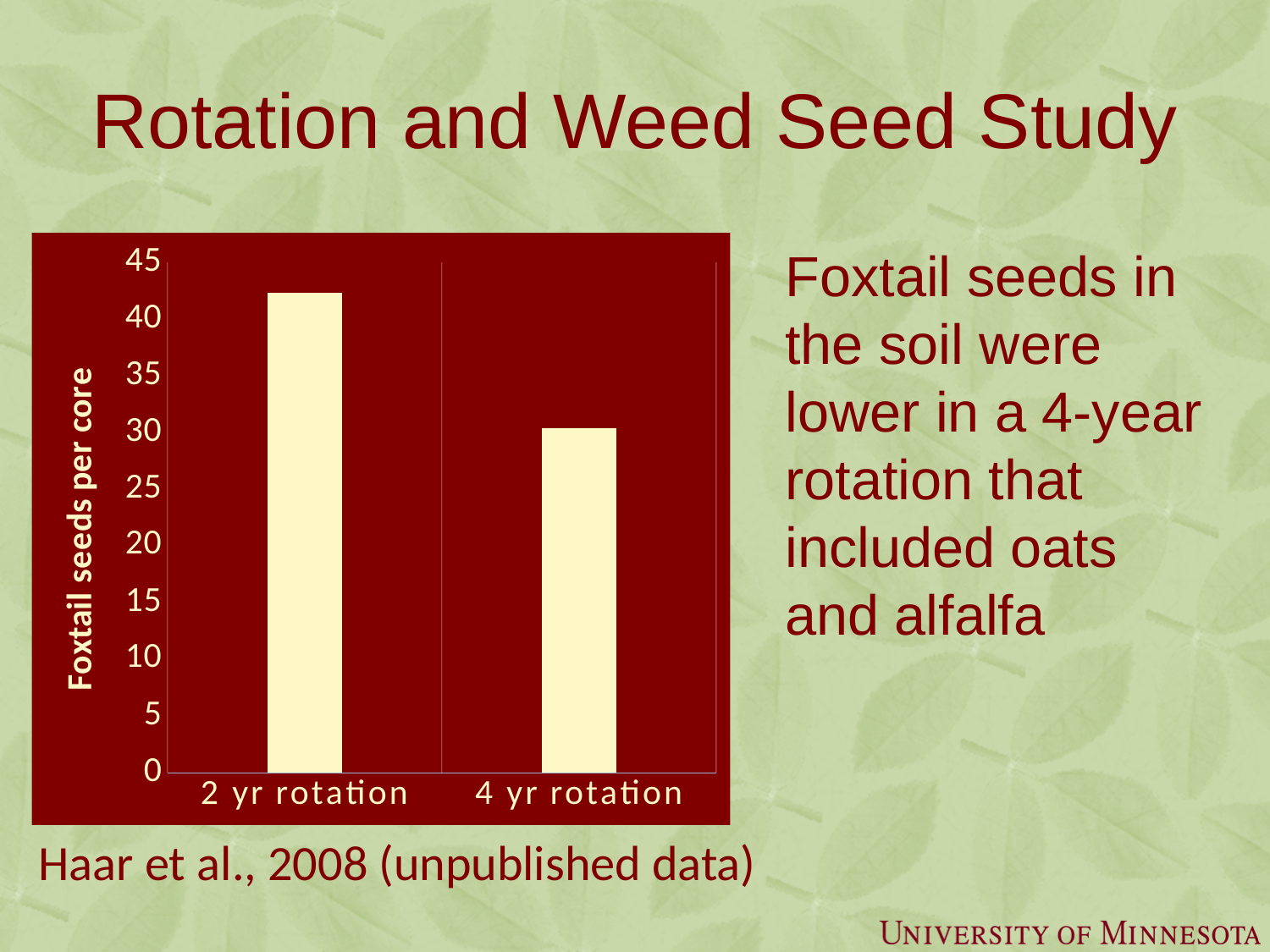
Do the values rise or fall from 2 yr rotation to 4 yr rotation along the x axis? fall Is the value for 4 yr rotation greater or less than 35? less How many categories are plotted on the x axis of the chart? 2 Is the value for 2 yr rotation greater or less than 40? greater Is the value for 4 yr rotation greater or less than 25? greater Which rotation has the lower number of foxtail seeds per core? 4 yr rotation What is the maximum value shown on the vertical axis of the chart? 45 Which is larger, the value for 2 yr rotation or the value for 4 yr rotation? 2 yr rotation Which rotation has the higher number of foxtail seeds per core? 2 yr rotation What kind of chart is shown on the slide? bar chart What is the label on the vertical axis of the chart? Foxtail seeds per core